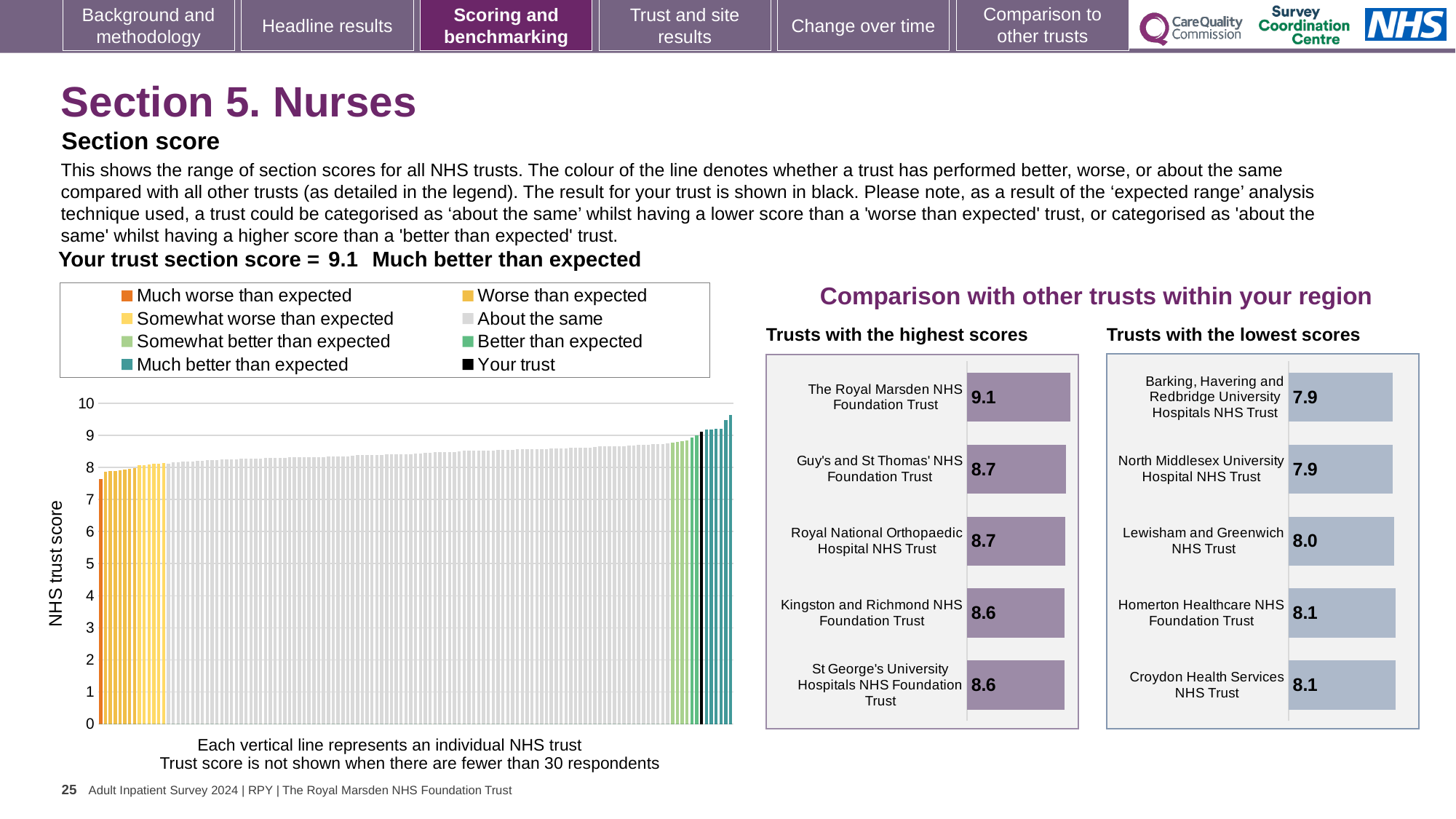
How many trusts are shown in the 'Trusts with the highest scores' chart? 5 In the 'Trusts with the lowest scores' chart, what is the score for Lewisham and Greenwich NHS Trust? 8.0 What kind of chart is the large chart on the left showing NHS trust scores? bar chart In the 'Trusts with the lowest scores' chart, what is the difference between the scores of Homerton Healthcare NHS Foundation Trust and Barking, Havering and Redbridge University Hospitals NHS Trust? 0.2 How many entries does the legend of the large chart on the left list? 8 In the 'Trusts with the highest scores' chart, what is the score for Kingston and Richmond NHS Foundation Trust? 8.6 In the 'Trusts with the lowest scores' chart, what is the score for Croydon Health Services NHS Trust? 8.1 In the large chart on the left, is the value of the black 'Your trust' bar greater or less than 8? greater In the 'Trusts with the lowest scores' chart, which has the larger score: Lewisham and Greenwich NHS Trust or Homerton Healthcare NHS Foundation Trust? Homerton Healthcare NHS Foundation Trust In the 'Trusts with the highest scores' chart, which trust has the highest score? The Royal Marsden NHS Foundation Trust In the 'Trusts with the highest scores' chart, what is the score for The Royal Marsden NHS Foundation Trust? 9.1 In the 'Trusts with the highest scores' chart, what is the difference between the scores of The Royal Marsden NHS Foundation Trust and Guy's and St Thomas' NHS Foundation Trust? 0.4